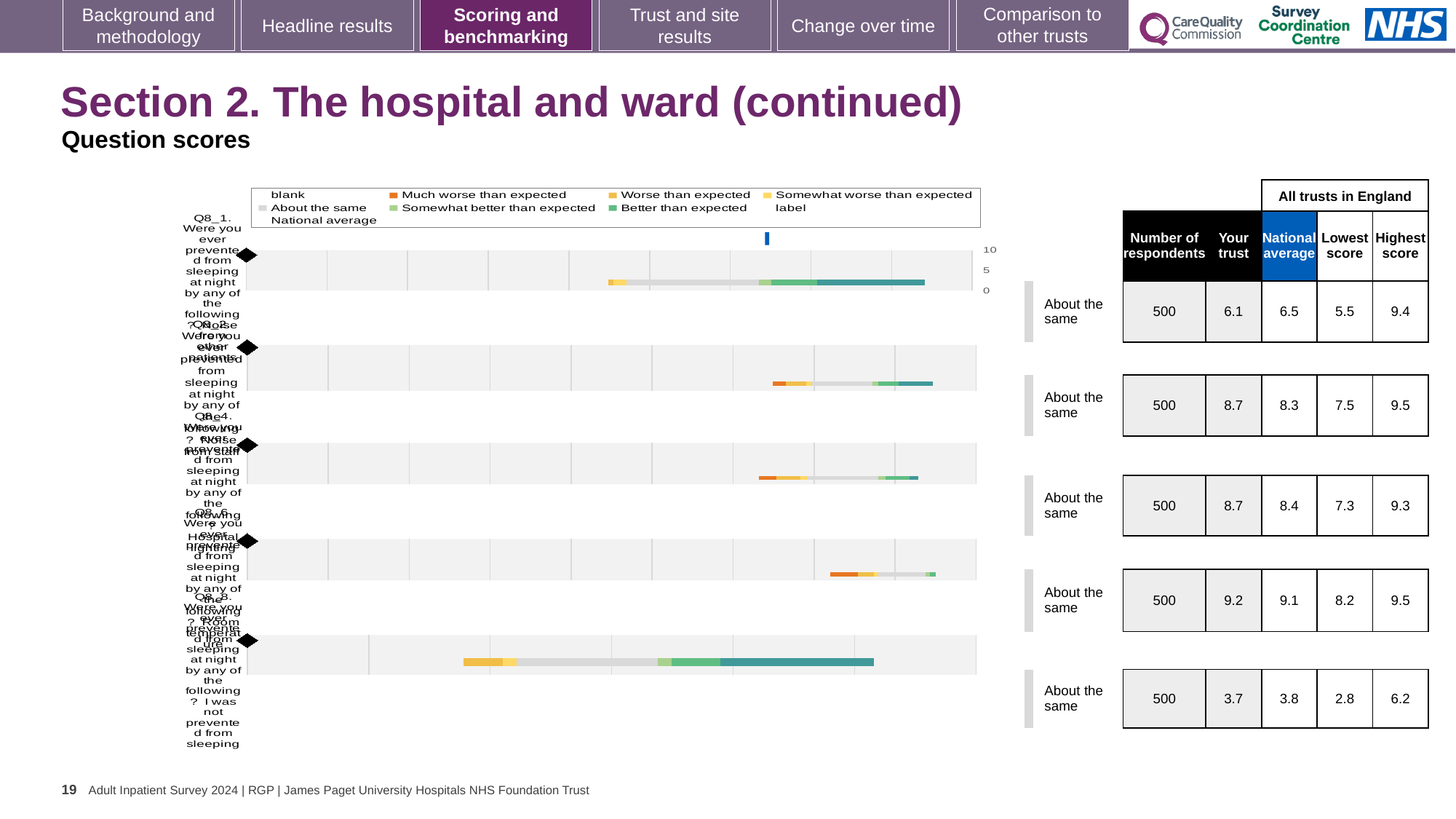
What benchmark label is shown next to each bar in the chart? About the same How many question rows (bars) are plotted in the chart? 5 What is the highest score among all trusts in England for the last (fifth) row? 6.2 For the third row, which is larger: the 'Your trust' score or the national average? Your trust (8.7) Which row has the highest 'Your trust' score? the fourth row (9.2) What is the national average for the first row (Q8_1)? 6.5 What is the number of respondents shown for the second row? 500 What is the 'Your trust' score for the first row (Q8_1) in the table beside the chart? 6.1 Which row has the lowest 'Your trust' score? the fifth row (3.7) What kind of chart is shown on the slide? bar chart What is the lowest score among all trusts in England for the fourth row? 8.2 What is the difference between the 'Your trust' score and the national average for the second row? 0.4